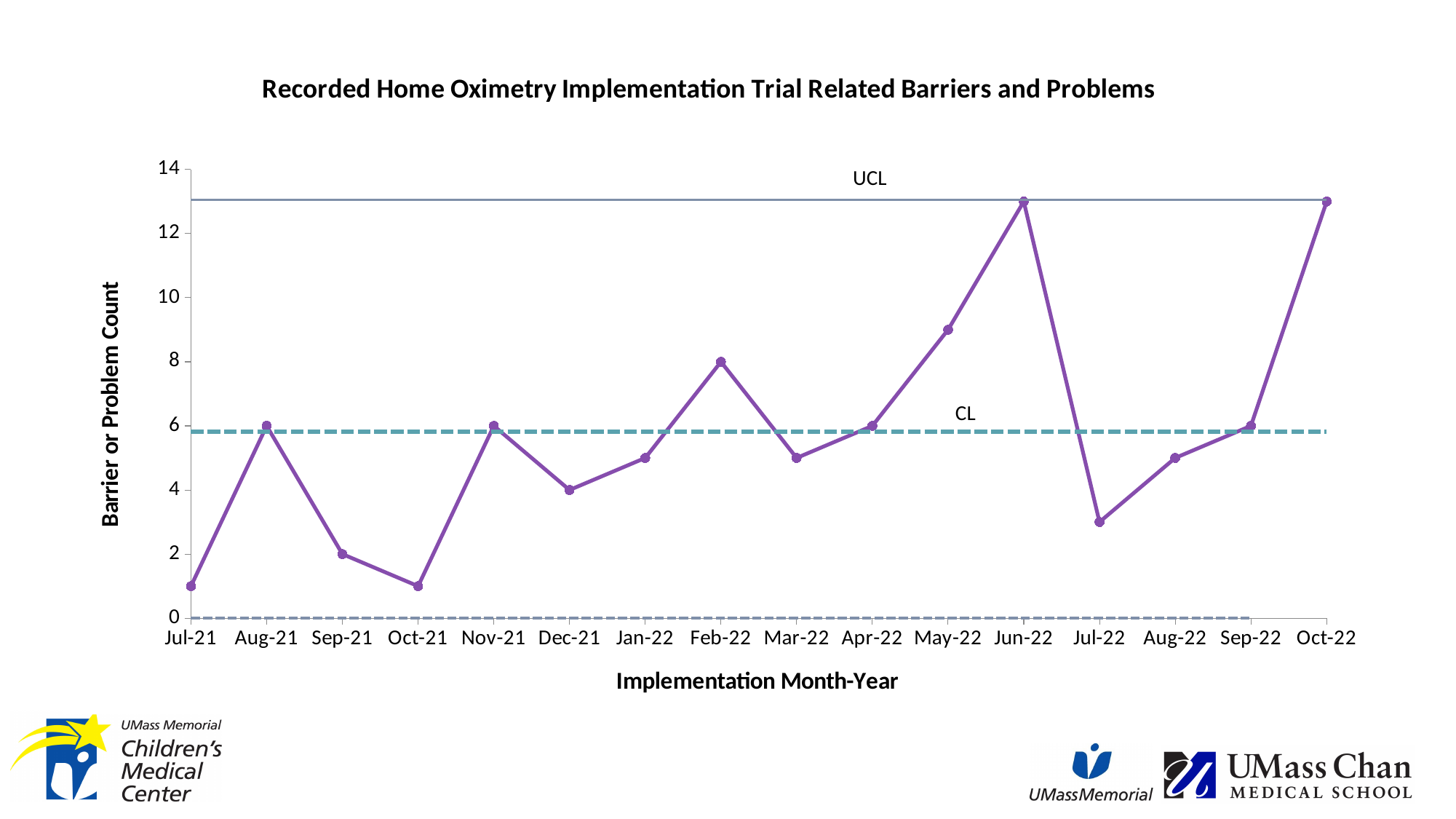
What is the barrier or problem count for Dec-21? 4 Is the value for May-22 greater or less than 8? greater What is the difference between the values for Feb-22 and Dec-21? 4 Which has a higher value, Feb-22 or Sep-21? Feb-22 What is the label on the solid horizontal line near the top of the chart? UCL Is the value for Jul-22 greater or less than 4? less What kind of chart is shown on the slide? line chart What is the barrier or problem count for Feb-22? 8 Is the value for Jun-22 greater or less than 12? greater How many months are plotted on the x axis? 16 What is the barrier or problem count for Sep-21? 2 What is the barrier or problem count for Aug-21? 6